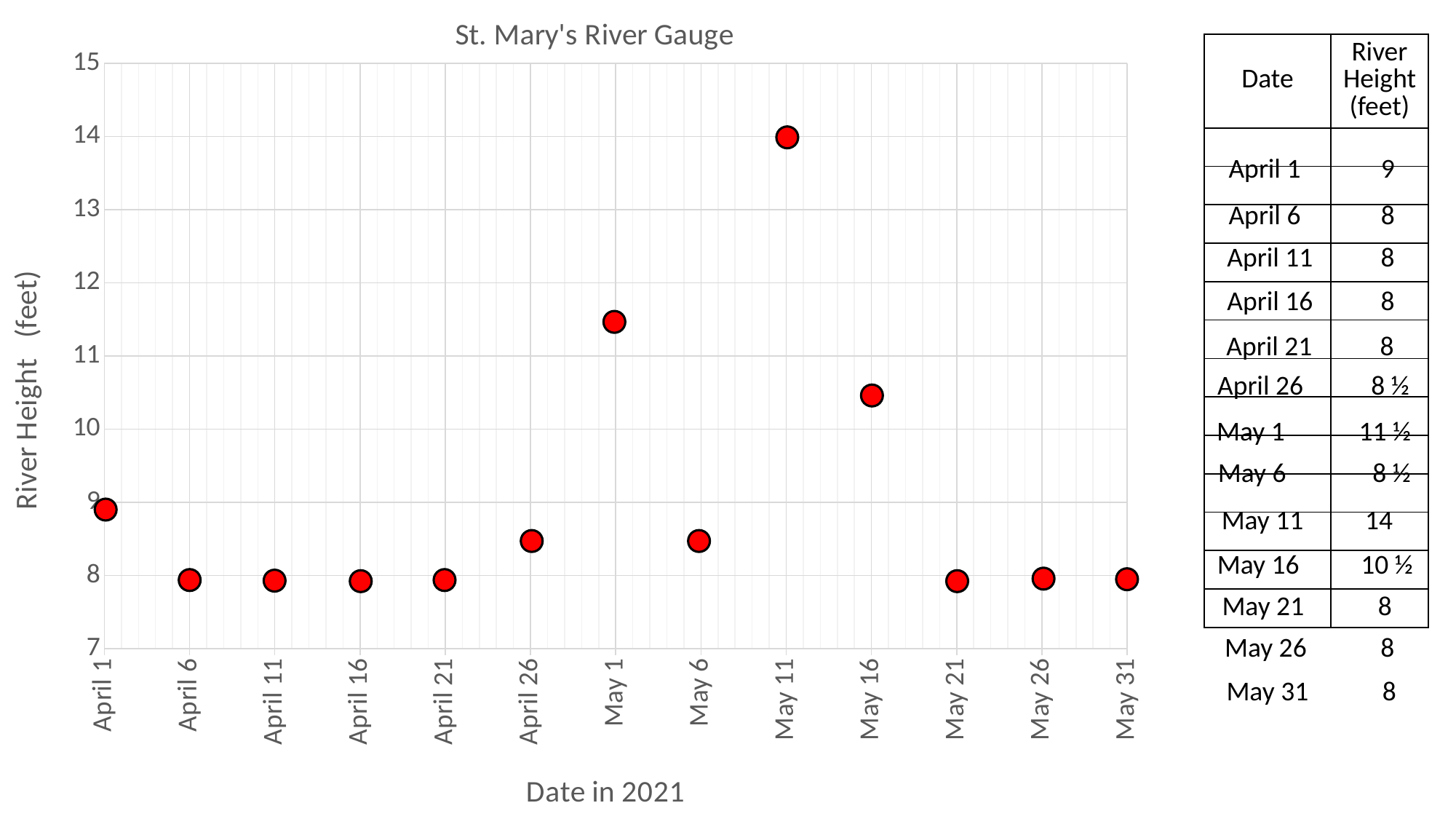
What was the river height on May 1? 11 ½ What is the label of the x axis? Date in 2021 What is the difference in river height between May 11 and May 21? 6 What is the title of the chart? St. Mary's River Gauge On which date was the river height highest? May 11 Is the river height on May 16 greater or less than 10? greater What was the river height on May 11? 14 How many data points are plotted on the chart? 13 Which date had a higher river height, May 1 or May 16? May 1 What was the river height on May 16? 10 ½ What was the river height on April 1? 9 What type of chart is shown on the slide? scatter chart